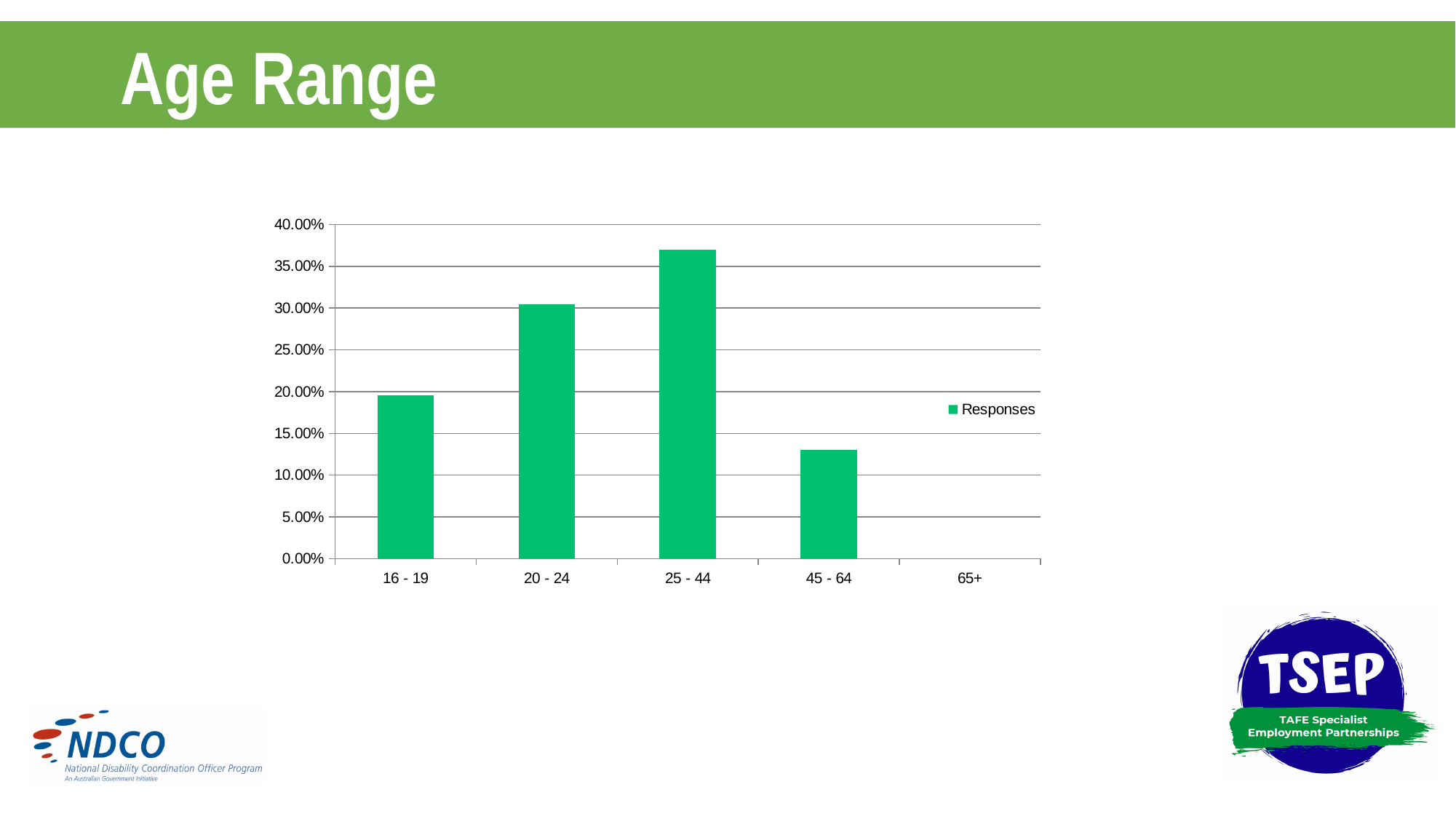
What is the name of the series shown in the legend? Responses Which age range has the highest value? 25 - 44 Is the value for 20 - 24 greater or less than 25.00%? greater Which age range has the lowest value? 65+ Is the value for 16 - 19 greater or less than 15.00%? greater What kind of chart is shown on the slide? bar chart How many series does the legend list? 1 Is the value for 45 - 64 greater or less than 15.00%? less How many age range categories are shown on the x axis? 5 Do the values rise or fall from 25 - 44 to 65+ along the x axis? fall Which is larger, the value for 20 - 24 or the value for 16 - 19? 20 - 24